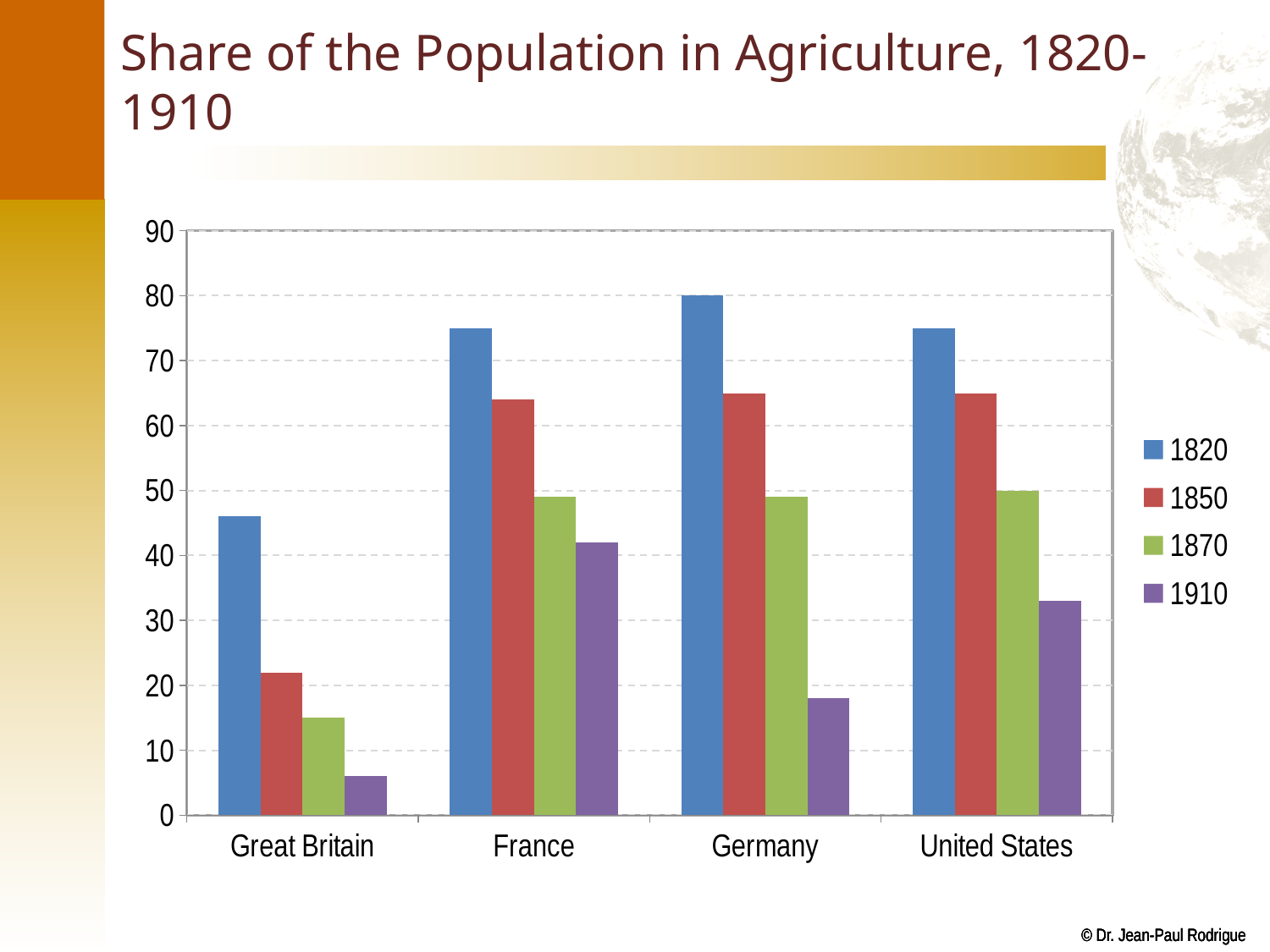
Is the value for France in 1820 greater or less than 70? greater Is the value for Great Britain in 1820 greater or less than 50? less Which country has the lowest value for 1910? Great Britain Which is larger, the 1910 value for France or the 1910 value for Germany? France What is the title of the chart on the slide? Share of the Population in Agriculture, 1820-1910 What kind of chart is shown on the slide? bar chart How many series does the legend list? 4 Which country has the highest value for 1820? Germany For Great Britain, do the values rise or fall from 1820 to 1910? fall How many countries are shown on the x axis of the chart? 4 What is the value for Germany in 1820? 80 Is the value for Great Britain in 1910 greater or less than 10? less